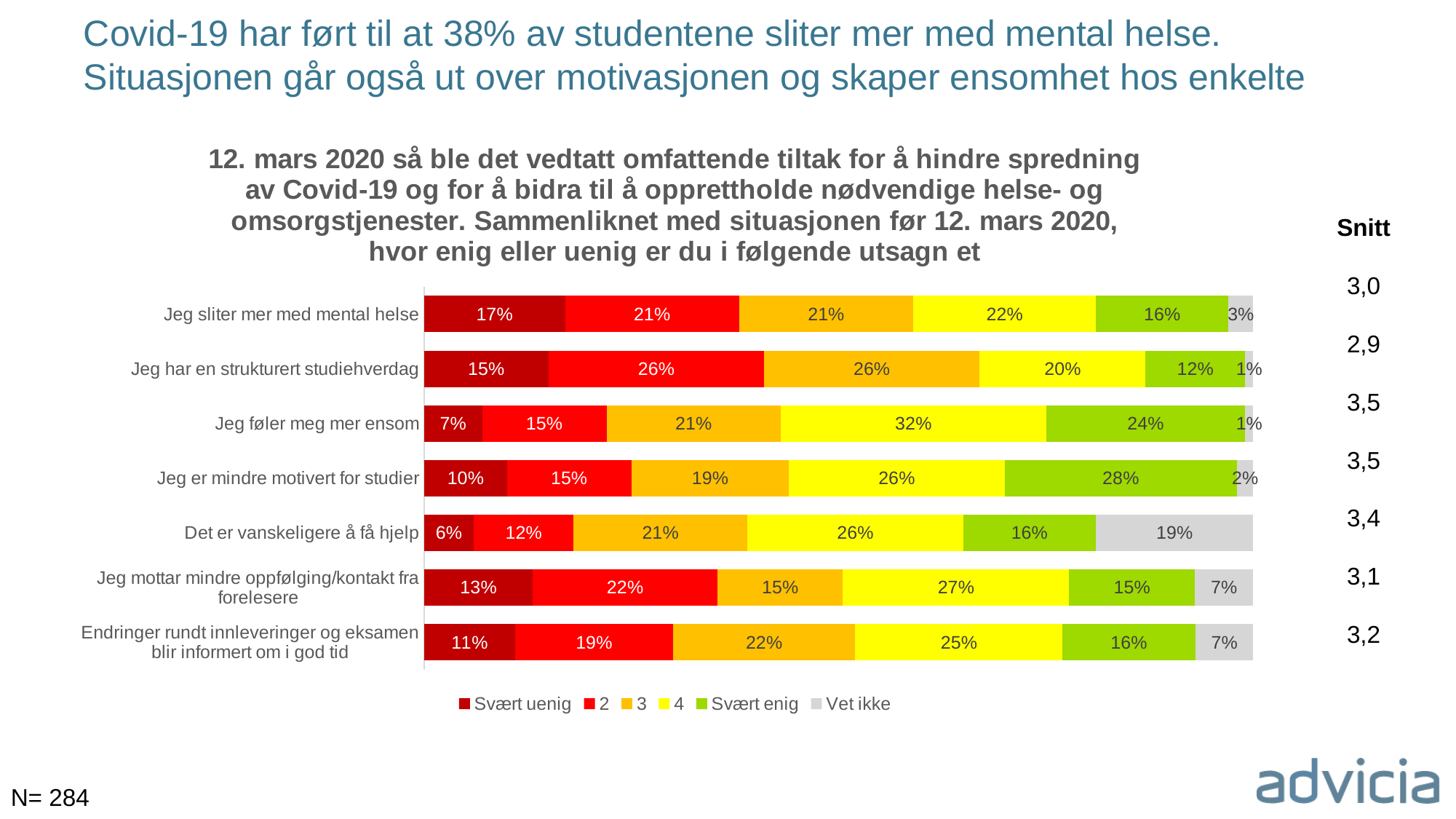
How many series does the legend list? 6 How many statements (categories) are shown in the chart? 7 Which statement has the highest "Svært uenig" percentage? Jeg sliter mer med mental helse What percentage answered "4" for "Jeg føler meg mer ensom"? 32% What is the Snitt (average) value shown for "Jeg er mindre motivert for studier"? 3,5 Which is larger: the "2" share for "Jeg har en strukturert studiehverdag" or the "2" share for "Jeg mottar mindre oppfølging/kontakt fra forelesere"? Jeg har en strukturert studiehverdag What is the sample size (N) stated on the slide? 284 What percentage of respondents answered "Svært uenig" to "Jeg sliter mer med mental helse"? 17% What is the "Vet ikke" share for "Det er vanskeligere å få hjelp"? 19% Which statement has the lowest Snitt value? Jeg har en strukturert studiehverdag What type of chart is shown on the slide? Stacked bar chart What is the difference between the "Svært enig" percentages for "Jeg er mindre motivert for studier" and "Jeg har en strukturert studiehverdag"? 16%